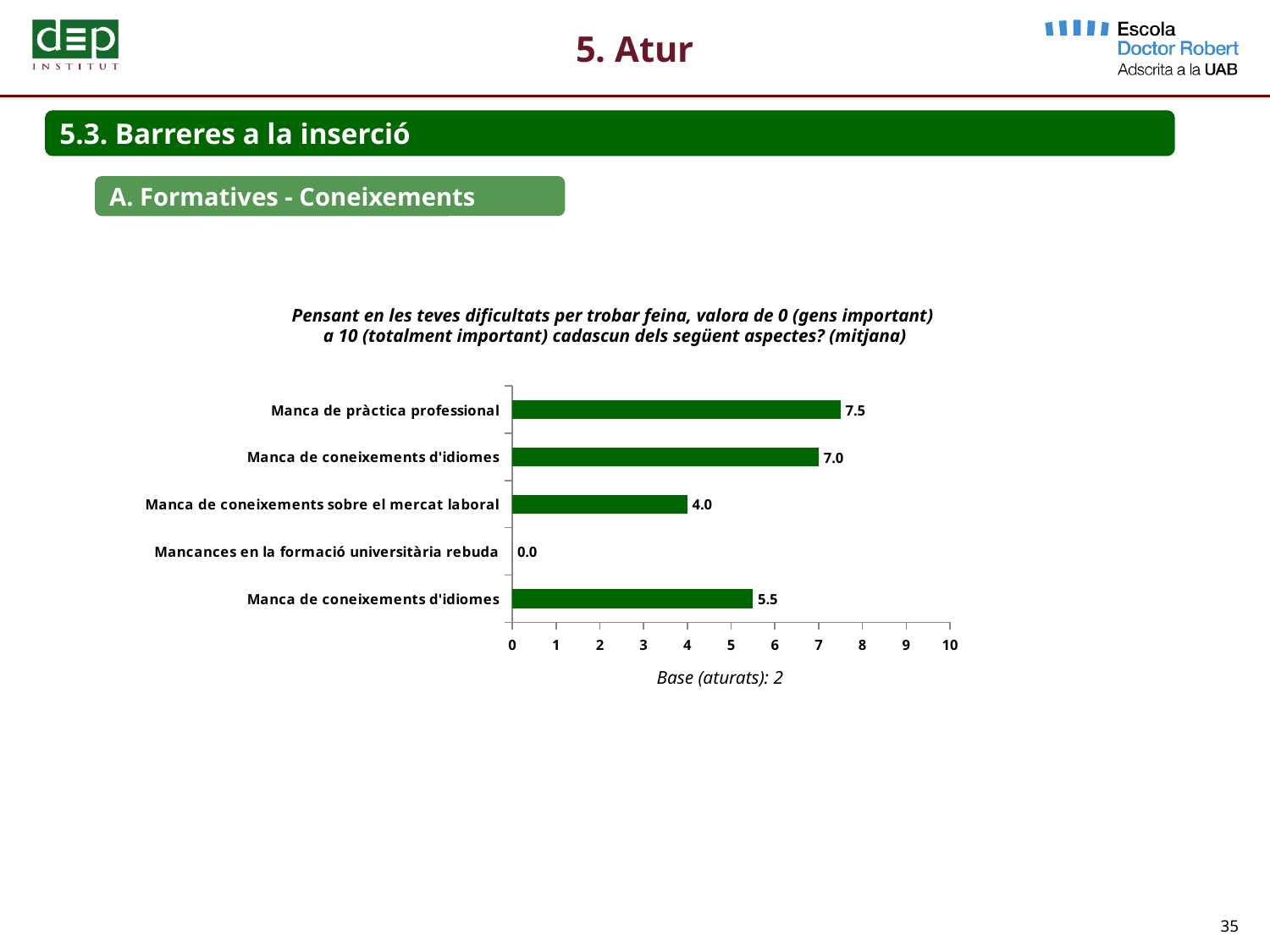
Which category has the lowest value? Mancances en la formació universitària rebuda Which category has the highest value? Manca de pràctica professional What kind of chart is shown on the slide? Bar chart What is the value for "Mancances en la formació universitària rebuda"? 0.0 What is the base (number of respondents) stated below the chart? 2 What is the value for "Manca de pràctica professional"? 7.5 Which is larger: the value for "Manca de pràctica professional" or the value for "Manca de coneixements sobre el mercat laboral"? Manca de pràctica professional What is the value of the bottom bar, labelled "Manca de coneixements d'idiomes"? 5.5 What is the value for "Manca de coneixements sobre el mercat laboral"? 4.0 What is the value of the second bar from the top, labelled "Manca de coneixements d'idiomes"? 7.0 What is the difference between the value for "Manca de pràctica professional" and the value for "Manca de coneixements sobre el mercat laboral"? 3.5 How many bars are shown in the chart? 5